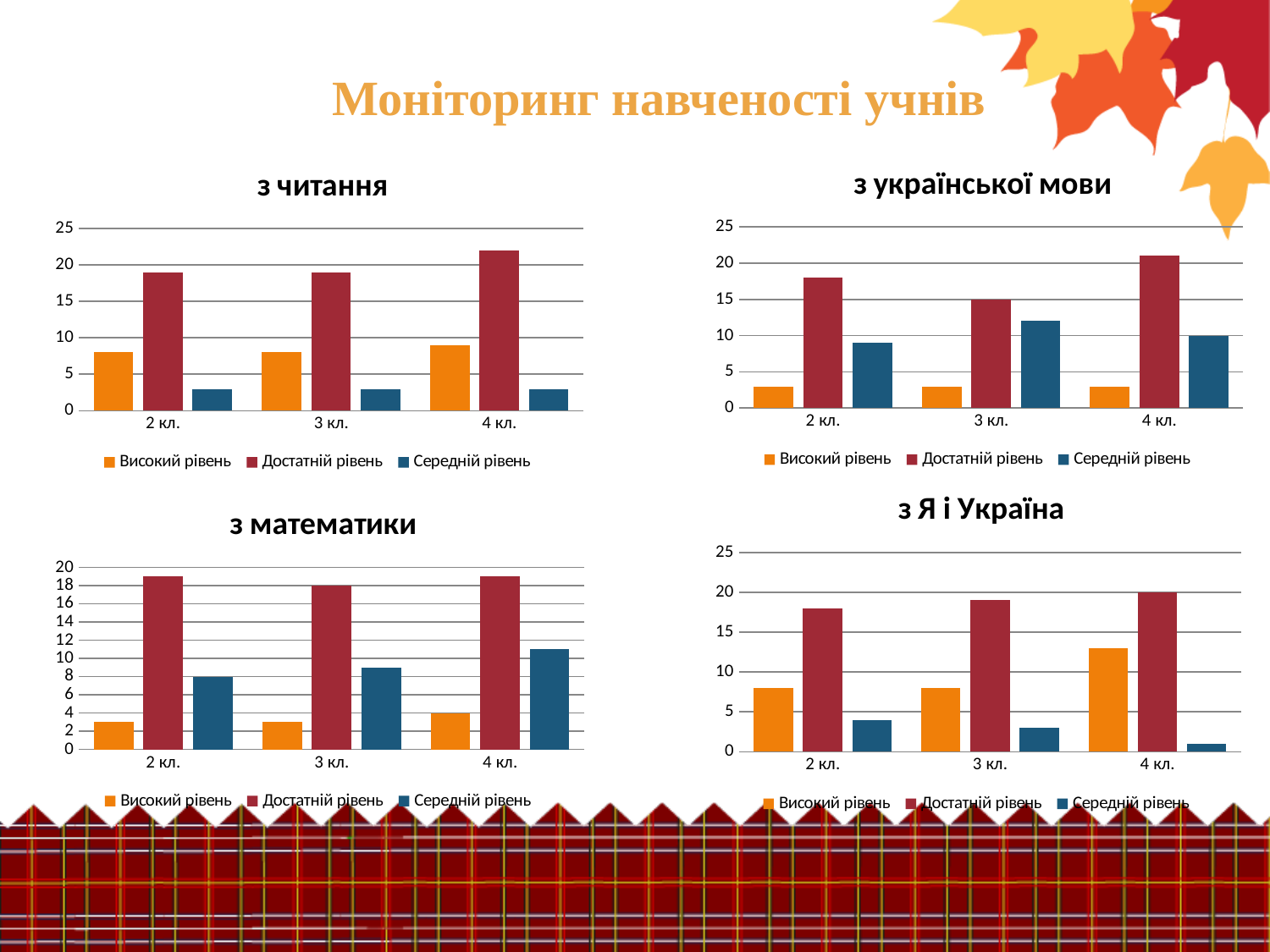
In the "з читання" chart, which class has the highest value for Достатній рівень? 4 кл. In the "з Я і Україна" chart, which is larger: Високий рівень in 4 кл. or Високий рівень in 2 кл.? Високий рівень in 4 кл. In the "з української мови" chart, which class has the lowest value for Достатній рівень? 3 кл. In the "з математики" chart, what is the value for Середній рівень in 2 кл.? 8 In the "з математики" chart, does the value for Середній рівень rise or fall from 2 кл. to 4 кл.? rise In the "з Я і Україна" chart, which class has the lowest value for Середній рівень? 4 кл. What kind of chart is the "з читання" chart? bar chart What colour are the Достатній рівень bars in the "з Я і Україна" chart? dark red In the "з читання" chart, is the value for Достатній рівень in 4 кл. greater or less than 20? greater How many class categories are shown on the x axis of the "з української мови" chart? 3 In the "з української мови" chart, is the value for Середній рівень in 3 кл. greater or less than 10? greater How many series does the legend of the "з математики" chart list? 3